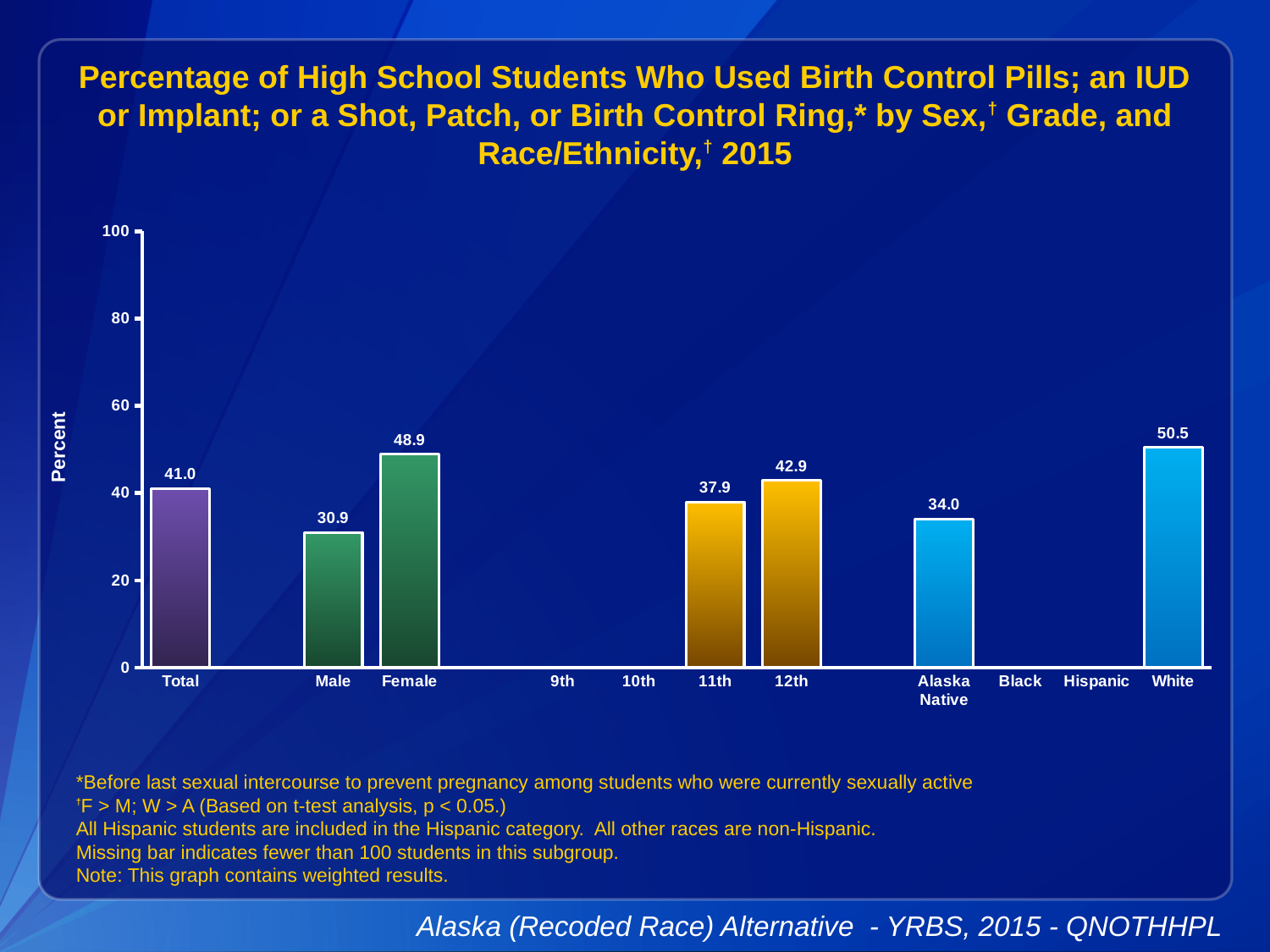
Which category has the highest value? White What is the value for 12th grade? 42.9 What is the label on the y axis? Percent What is the value for Male? 30.9 Which is larger, the value for 11th grade or 12th grade? 12th What kind of chart is this? bar chart How many categories have a bar shown? 7 Is the value for White greater or less than 40? greater What is the value for Female? 48.9 What is the difference between the Female and Male values? 18.0 Which category with a bar has the lowest value? Male What is the value for Alaska Native? 34.0